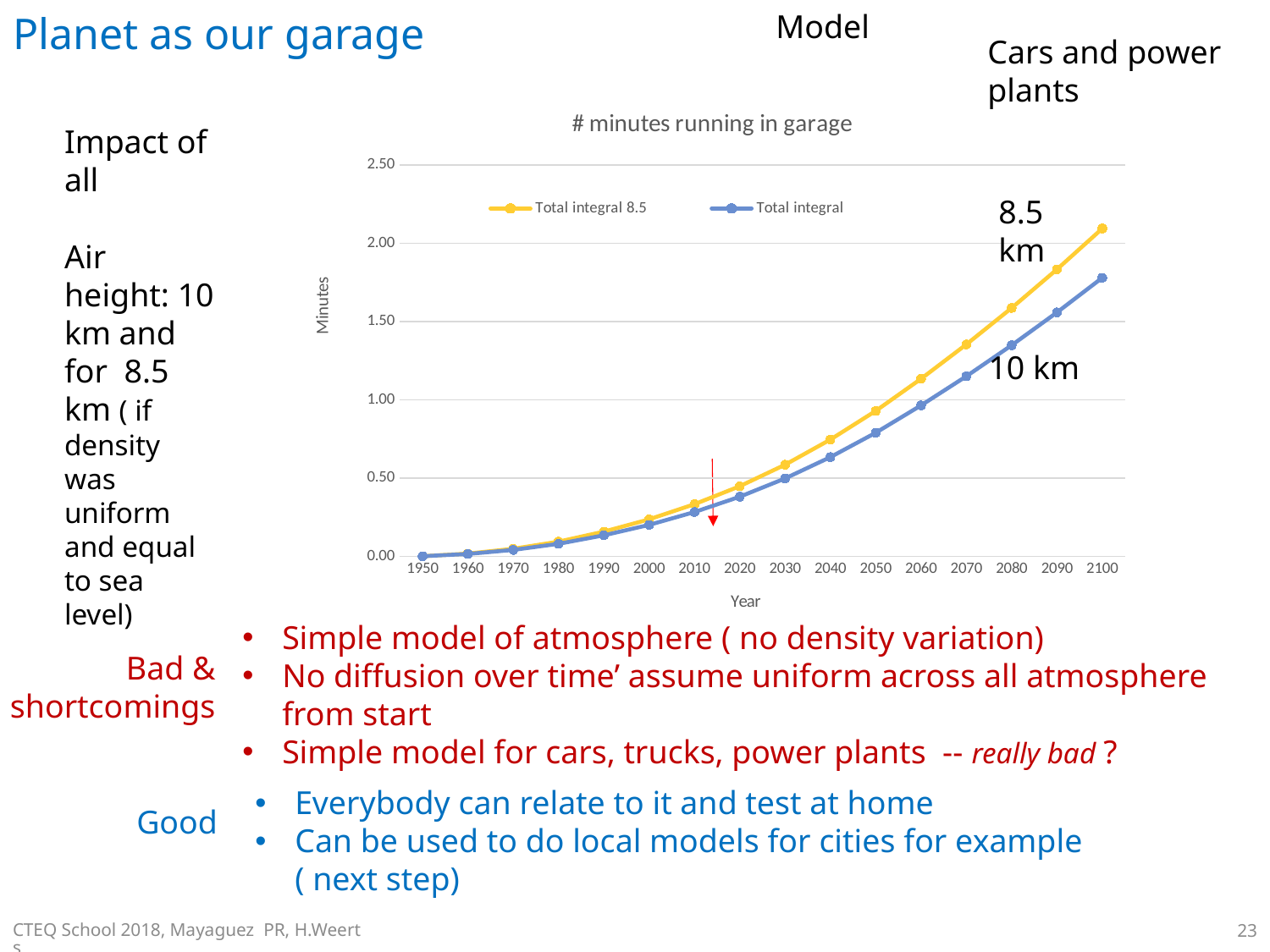
Is the value of the Total integral series in 2050 greater or less than 0.50? greater What is the title of the chart? # minutes running in garage What is the label of the y axis of the chart? Minutes Is the value of the Total integral series in 2100 greater or less than 2.00? less Which series has the higher value in 2100, Total integral 8.5 or Total integral? Total integral 8.5 Do the values of the Total integral 8.5 series rise or fall from 1950 to 2100? rise In which year does the Total integral series reach its highest value? 2100 Is the value of the Total integral 8.5 series in 2100 greater or less than 2.00? greater What kind of chart is shown on the slide? line chart How many years are plotted along the x axis of the chart? 16 How many series does the chart legend list? 2